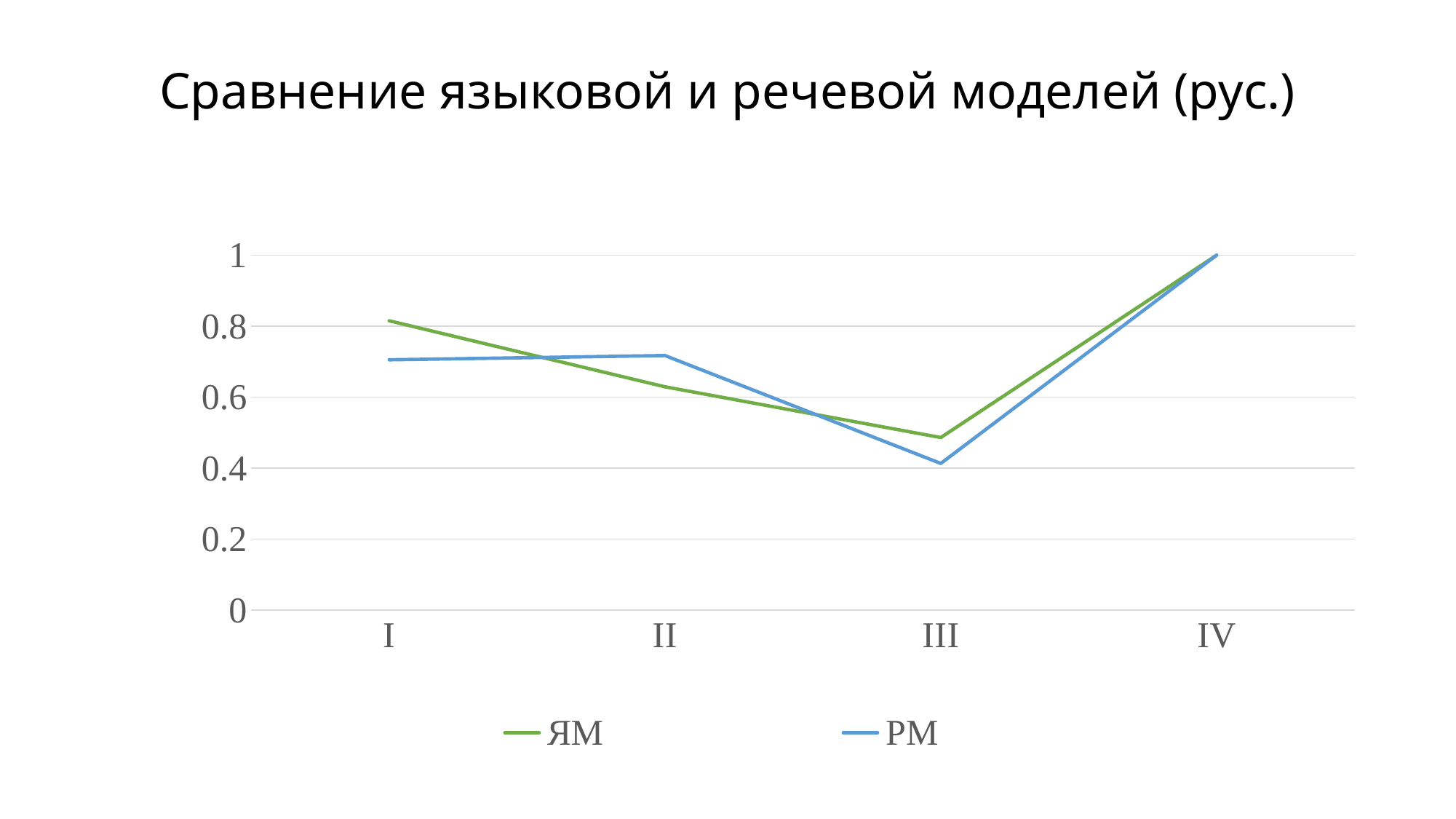
What is the value of ЯМ at category IV? 1 What is the title of the chart? Сравнение языковой и речевой моделей (рус.) At category III, which series has the higher value, ЯМ or РМ? ЯМ At which category does the ЯМ series reach its lowest value? III Is the value for РМ at category III greater or less than 0.6? less Do the values of both series rise or fall from category III to category IV? rise How many series does the legend list? 2 How many categories are shown on the x axis? 4 What kind of chart is shown on the slide? line chart At which category does the РМ series reach its lowest value? III At category I, which series has the higher value, ЯМ or РМ? ЯМ What is the value of РМ at category IV? 1